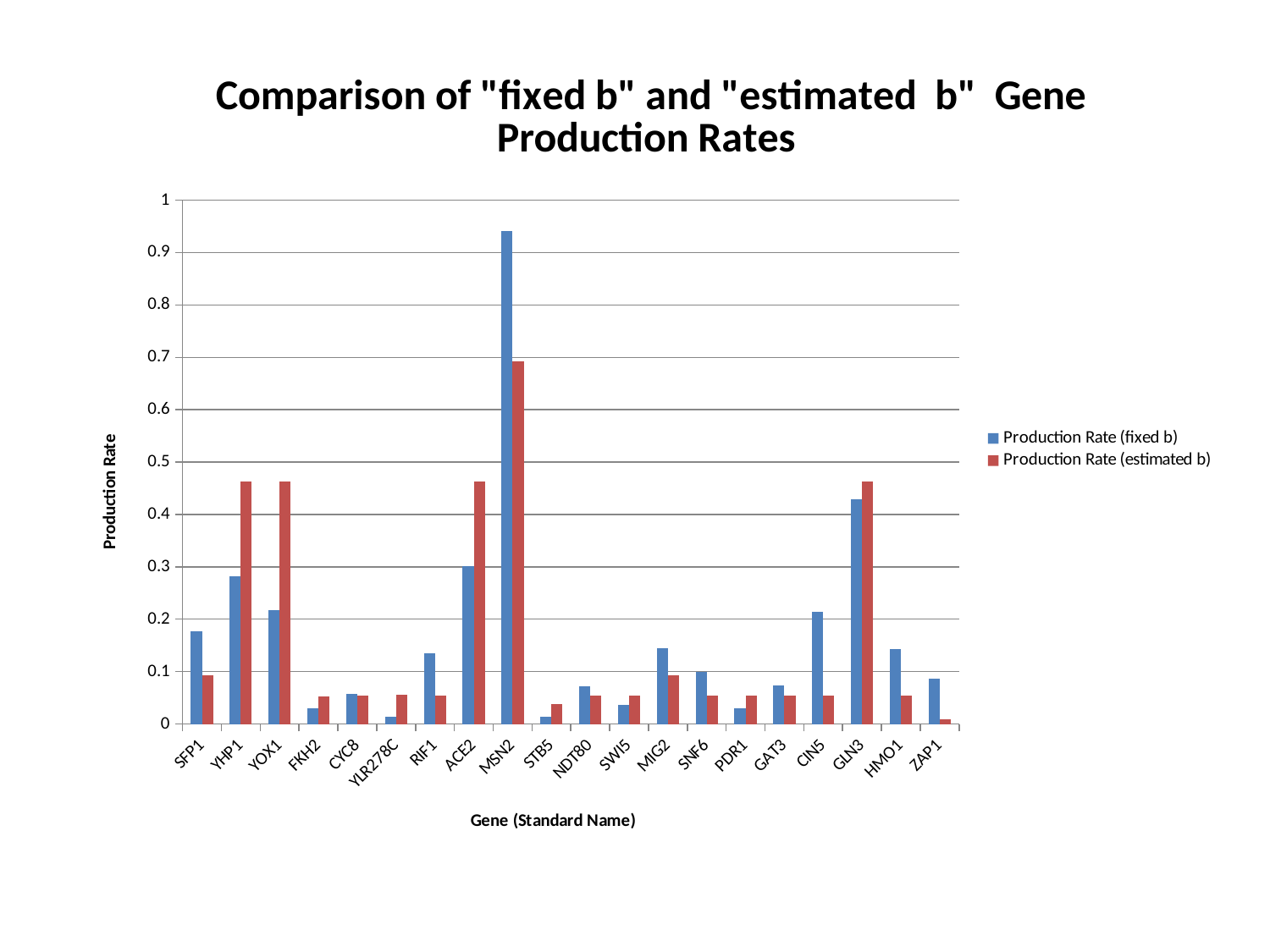
Is the Production Rate (fixed b) for SFP1 greater or less than 0.2? less Which gene has the highest Production Rate (fixed b)? MSN2 For CIN5, which is larger: Production Rate (fixed b) or Production Rate (estimated b)? Production Rate (fixed b) Which gene has the highest Production Rate (estimated b)? MSN2 For YHP1, which is larger: Production Rate (fixed b) or Production Rate (estimated b)? Production Rate (estimated b) Is the Production Rate (fixed b) for GLN3 greater or less than 0.4? greater Which gene has the lowest Production Rate (estimated b)? ZAP1 What is the label of the x axis? Gene (Standard Name) What kind of chart is shown on the slide? bar chart How many series does the legend list? 2 Is the Production Rate (fixed b) for MSN2 greater or less than 0.9? greater How many genes are shown along the x axis? 20